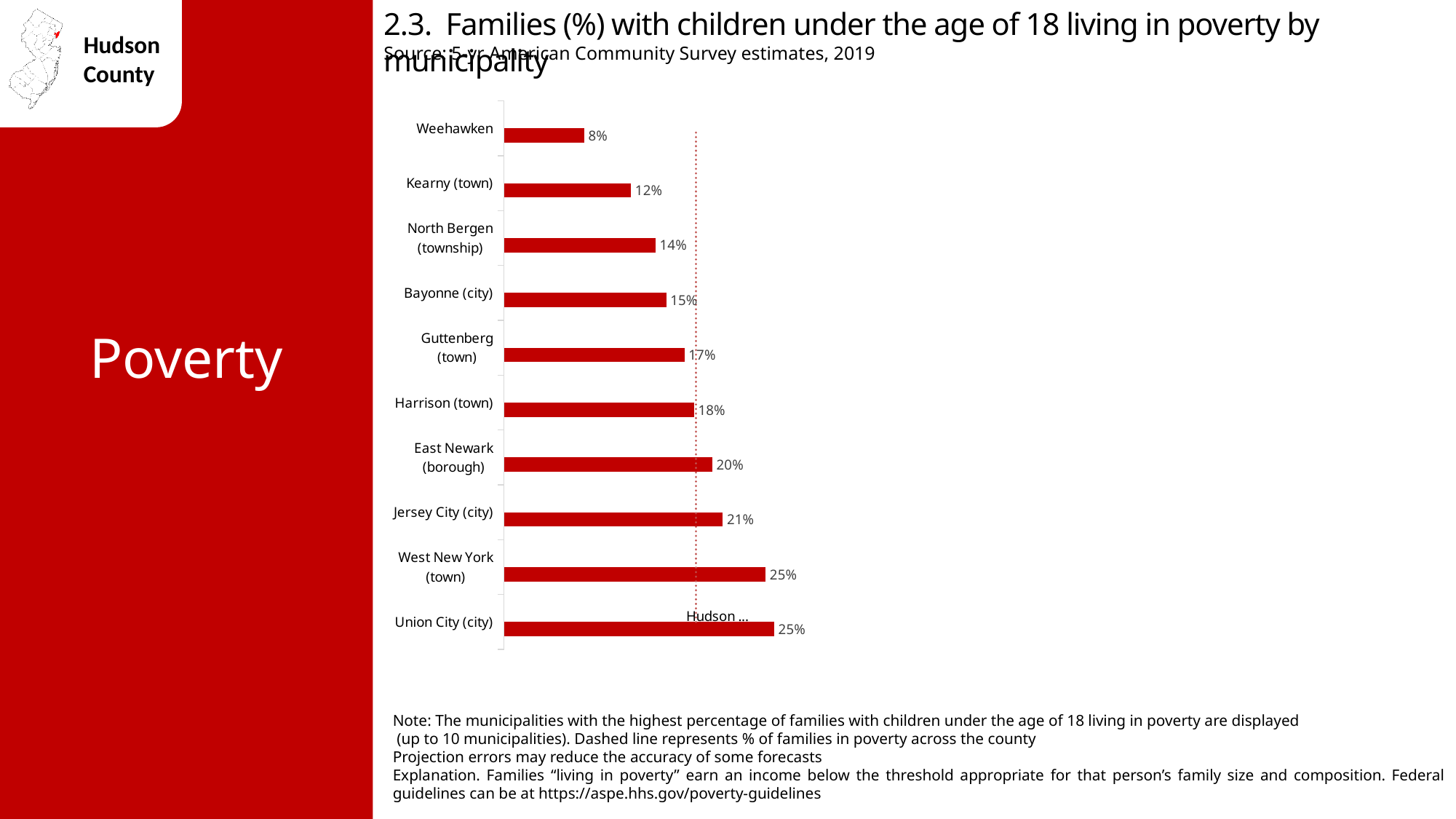
What is the difference between the values for West New York (town) and Kearny (town)? 13% Which municipality has the lowest percentage of families with children under 18 living in poverty? Weehawken How many municipalities are shown in the chart? 10 What is the value shown for Guttenberg (town)? 17% Which has a higher value, North Bergen (township) or Jersey City (city)? Jersey City (city) What type of chart is used on this slide? Bar chart What percentage of families with children under 18 live in poverty in Weehawken? 8% According to the note, what does the dashed line in the chart represent? % of families in poverty across the county Which has a higher value, Kearny (town) or Harrison (town)? Harrison (town) What is the difference between the values for Harrison (town) and Bayonne (city)? 3% What is the value shown for Jersey City (city)? 21% What is the value shown for East Newark (borough)? 20%